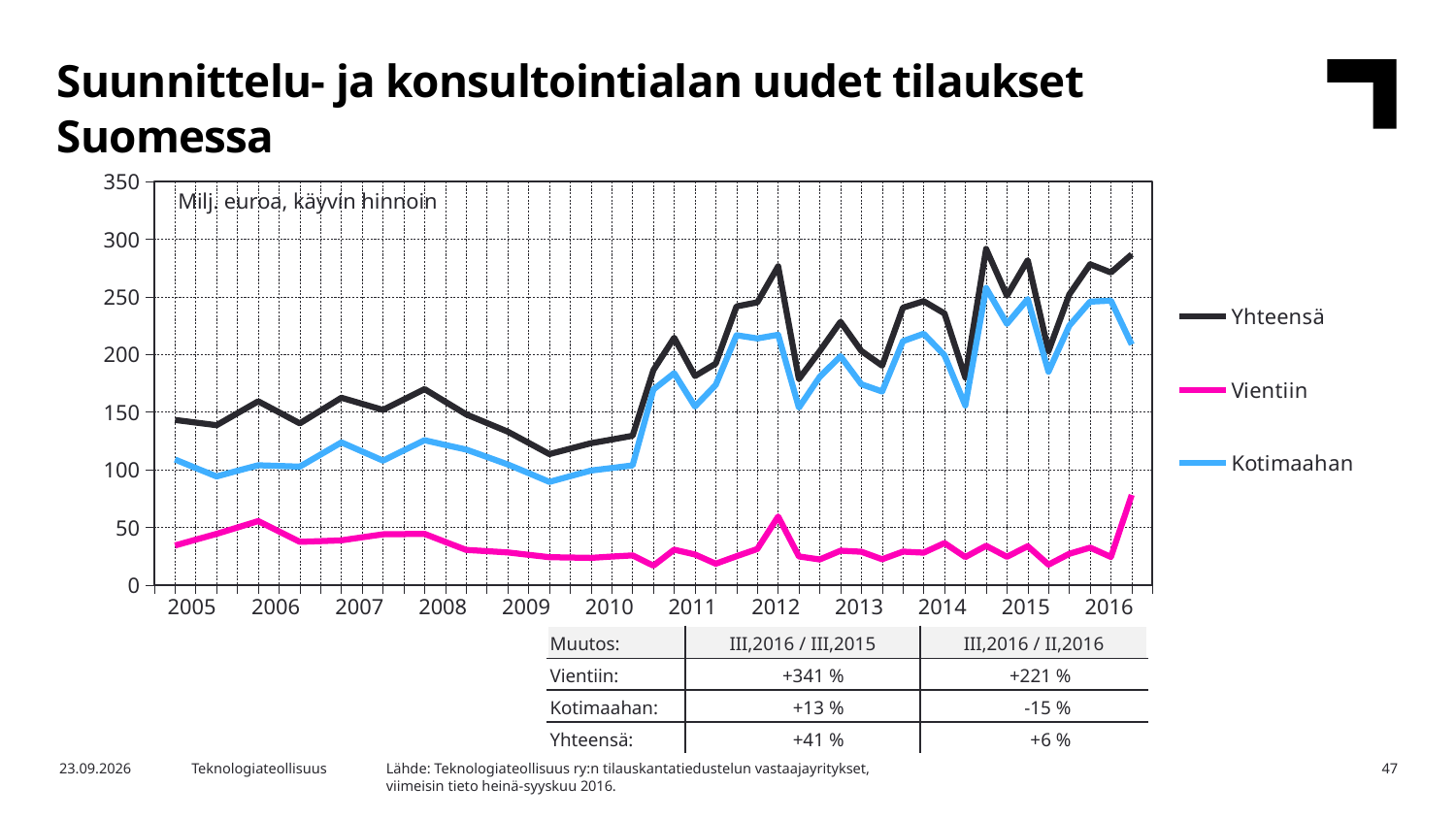
Which series has the lowest values across the whole chart? Vientiin How many series does the chart legend list? 3 What are the three series named in the chart legend? Yhteensä, Vientiin, Kotimaahan What type of chart is shown on the slide? line chart Which series has the highest values across the whole chart? Yhteensä Is the first value for Vientiin in 2005 greater or less than 50? less Is the highest value of Yhteensä greater or less than 250? greater Is the first value for Yhteensä in 2005 greater or less than 100? greater What unit label is printed inside the chart area? Milj. euroa, käyvin hinnoin How many years are labelled on the x axis of the chart? 12 Overall, does the Yhteensä line rise or fall from 2005 to 2016? rise